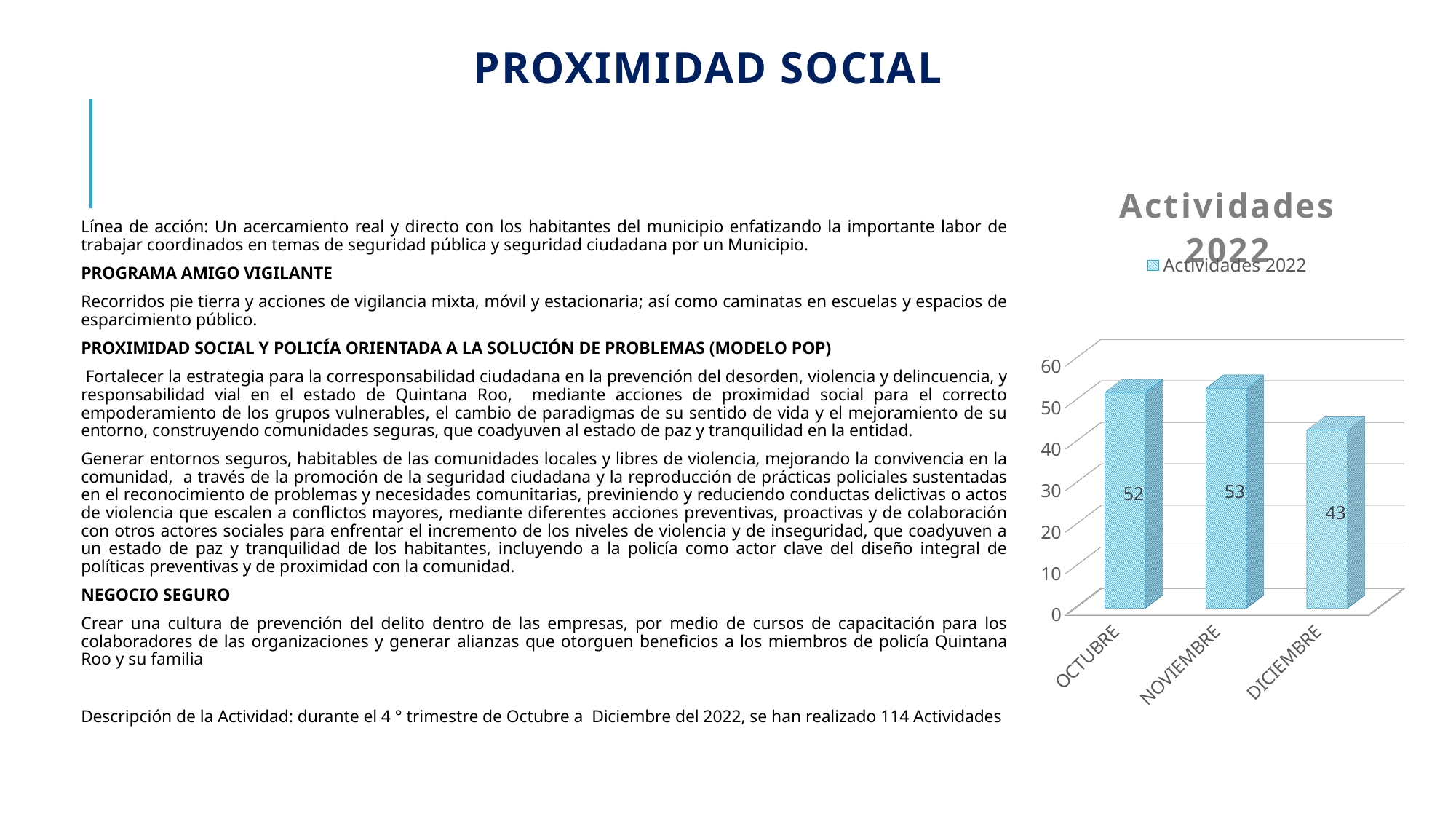
What is the title of the chart on the slide? Actividades 2022 What is the value for DICIEMBRE in the Actividades 2022 chart? 43 Which month has the lowest value in the Actividades 2022 chart? DICIEMBRE Is the value for DICIEMBRE greater or less than 50? less What kind of chart is shown on the slide? bar chart What is the value for OCTUBRE in the Actividades 2022 chart? 52 Which is larger, the value for OCTUBRE or the value for DICIEMBRE? OCTUBRE What is the difference between the values for OCTUBRE and DICIEMBRE? 9 What is the value for NOVIEMBRE in the Actividades 2022 chart? 53 How many series does the chart legend list? 1 What is the difference between the values for NOVIEMBRE and DICIEMBRE? 10 How many months are shown on the x axis of the chart? 3